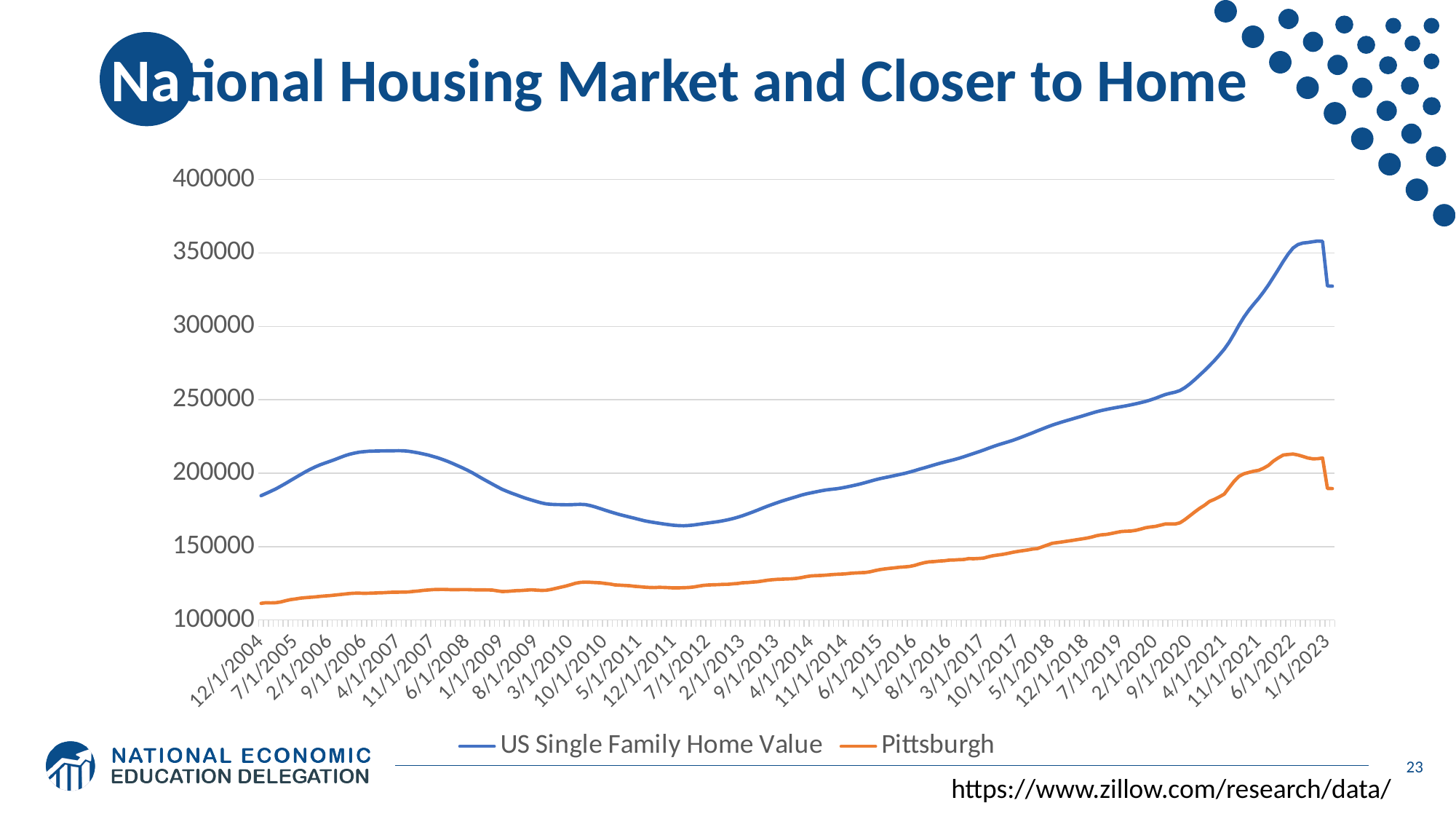
Is the value for Pittsburgh at 1/1/2023 greater or less than 200000? less Is the peak value of the US Single Family Home Value series greater or less than 300000? greater Is the peak value of the Pittsburgh series greater or less than 200000? greater How many series does the legend list? 2 What kind of chart is shown on the slide? Line chart Which series is drawn in orange? Pittsburgh Which series has the higher values across the whole chart, US Single Family Home Value or Pittsburgh? US Single Family Home Value What are the two series named in the legend? US Single Family Home Value and Pittsburgh Does the Pittsburgh series generally rise or fall from 12/1/2004 to 6/1/2022? Rise